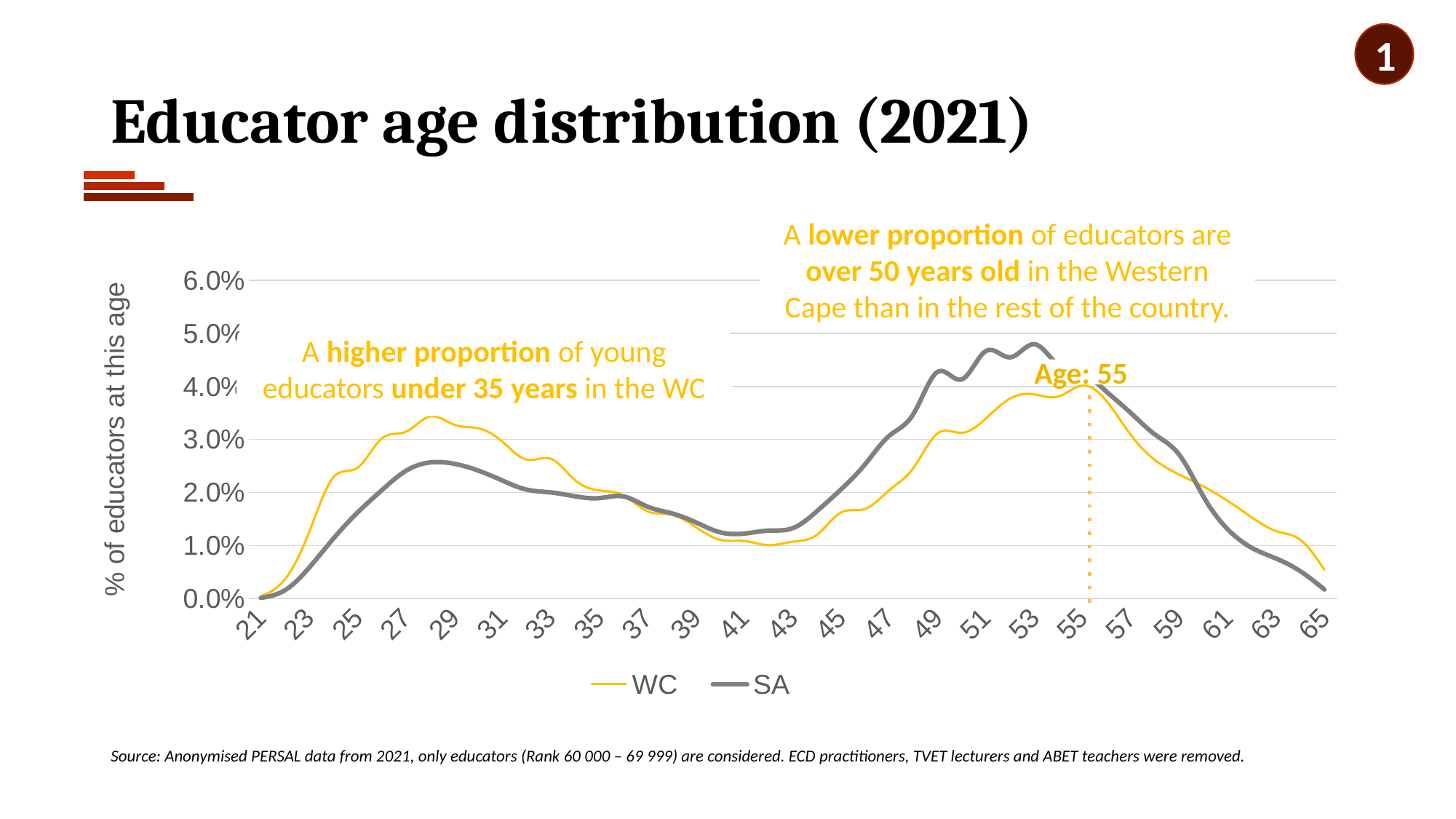
Which age does the dotted vertical line on the chart mark? Age: 55 What is the title of the chart? Educator age distribution (2021) How many series does the legend list? 2 Is the WC value at age 41 greater or less than 2.0%? less Is the WC value at age 29 greater or less than 3.0%? greater Does the SA line rise or fall between age 43 and age 51? rise Is the SA value at age 29 greater or less than 3.0%? less At age 51, which series has the higher value, WC or SA? SA At age 25, which series has the higher value, WC or SA? WC Does the WC line rise or fall between age 55 and age 65? fall What kind of chart is shown on the slide? line chart